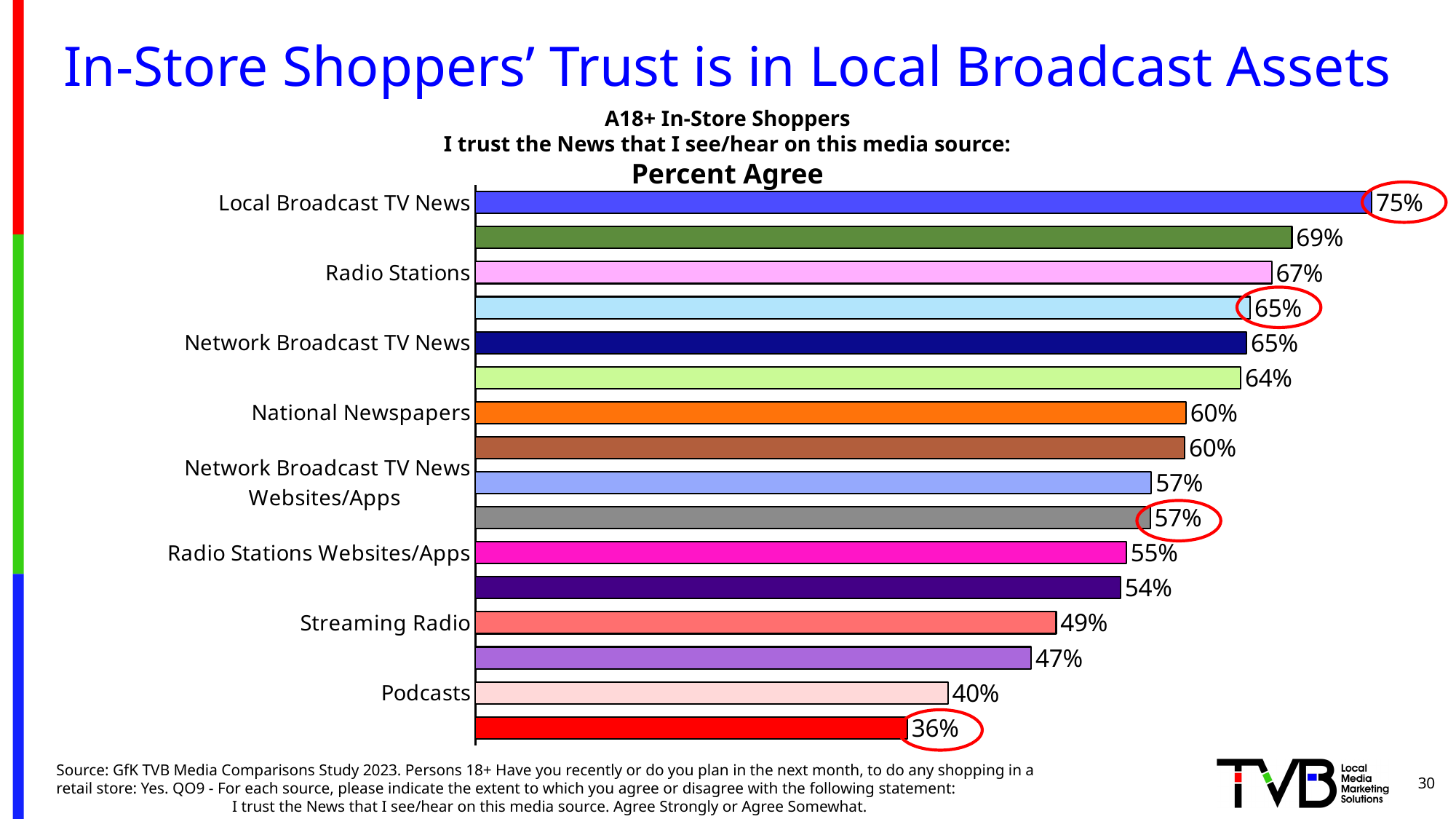
What is the difference in percent agree between Local Broadcast TV News and Network Broadcast TV News? 10 percentage points What is the lowest percent agree value shown on the chart? 36% What is the percent agree value for Network Broadcast TV News? 65% What is the percent agree value for National Newspapers? 60% How many bars are plotted on the chart? 16 What is the percent agree value for Podcasts? 40% What is the percent agree value for Radio Stations? 67% What percent of A18+ in-store shoppers agree they trust the news on Local Broadcast TV News? 75% Which labeled media source has the highest percent agree? Local Broadcast TV News What is the title of the slide? In-Store Shoppers' Trust is in Local Broadcast Assets What type of chart is shown on the slide? Bar chart Which has a higher percent agree, Streaming Radio or Radio Stations Websites/Apps? Radio Stations Websites/Apps